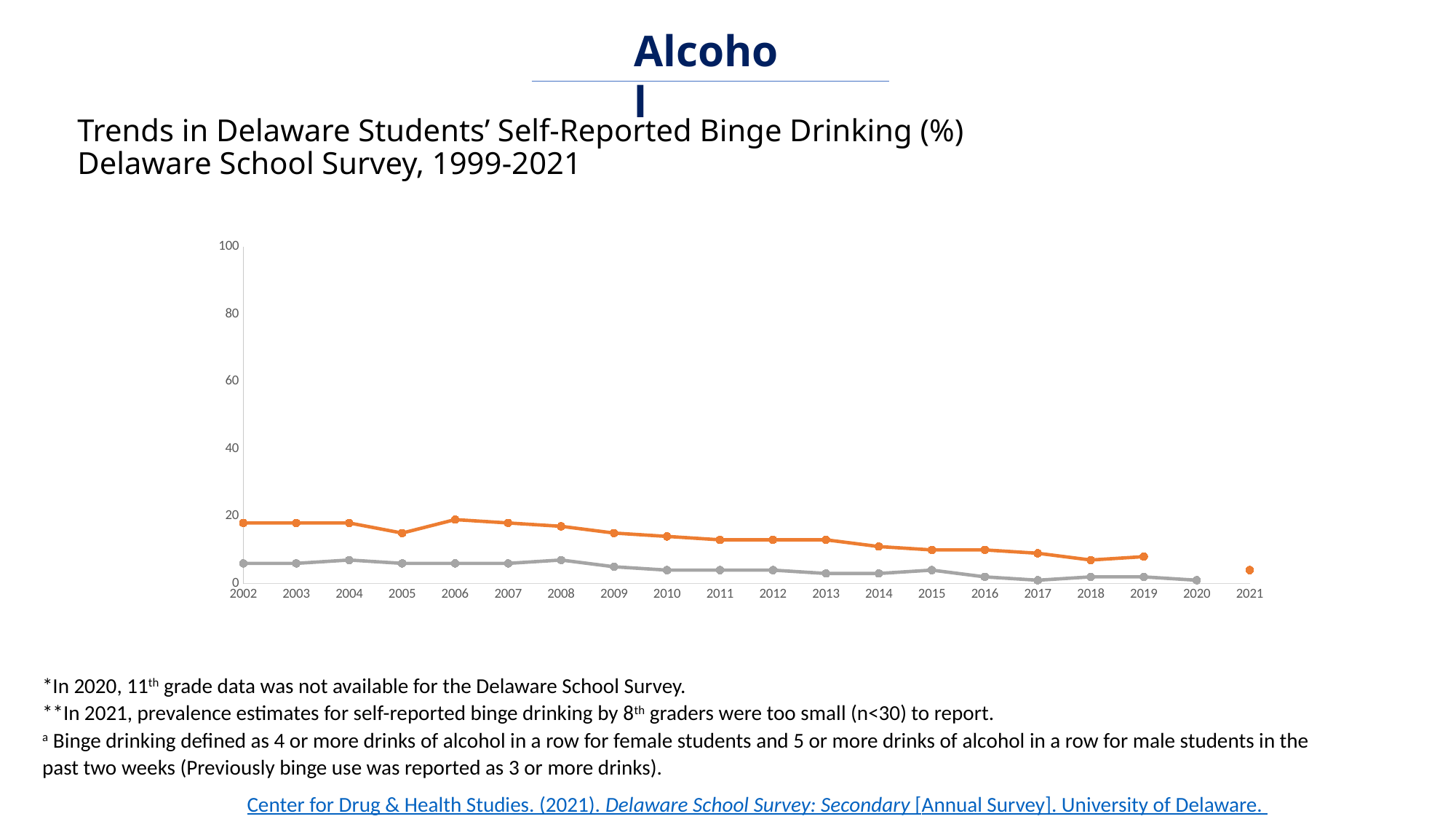
Is the value of the gray line for 2002 greater or less than 20? less How many years are labelled on the x axis of the chart? 20 Does the orange line generally rise or fall from 2002 to 2019? fall Is the value of the orange line for 2019 greater or less than 20? less What is the last year shown on the x axis? 2021 Is the value of the orange line for 2002 greater or less than 40? less How many lines are plotted on the chart? 2 What kind of chart is shown on the slide? line chart What is the first year shown on the x axis? 2002 In 2010, which line has the larger value, the orange line or the gray line? orange line Does the gray line generally rise or fall from 2008 to 2020? fall